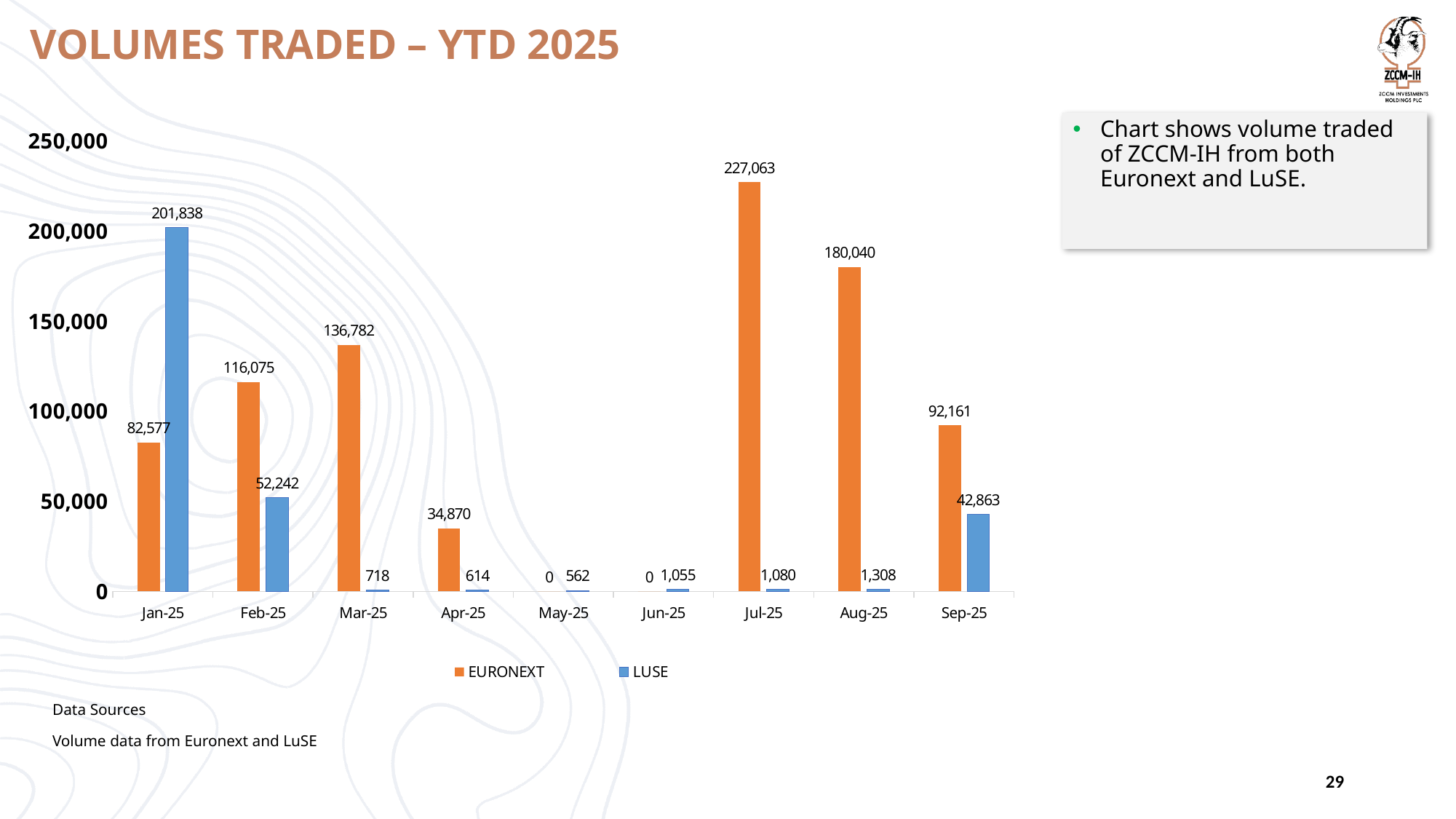
What is the difference between the LUSE and EURONEXT volumes in Jan-25? 119,261 How many months are shown on the x axis of the chart? 9 What is the EURONEXT volume traded in Jul-25? 227,063 In Feb-25, which series has the larger volume, EURONEXT or LUSE? EURONEXT What is the EURONEXT volume traded in May-25? 0 In which month is the LUSE volume lowest? May-25 In which month is the LUSE volume highest? Jan-25 What is the difference between the EURONEXT and LUSE volumes in Sep-25? 49,298 How many series does the chart's legend list? 2 Is the EURONEXT value for Aug-25 greater or less than 150,000? greater What is the LUSE volume traded in Jan-25? 201,838 In which month is the EURONEXT volume highest? Jul-25